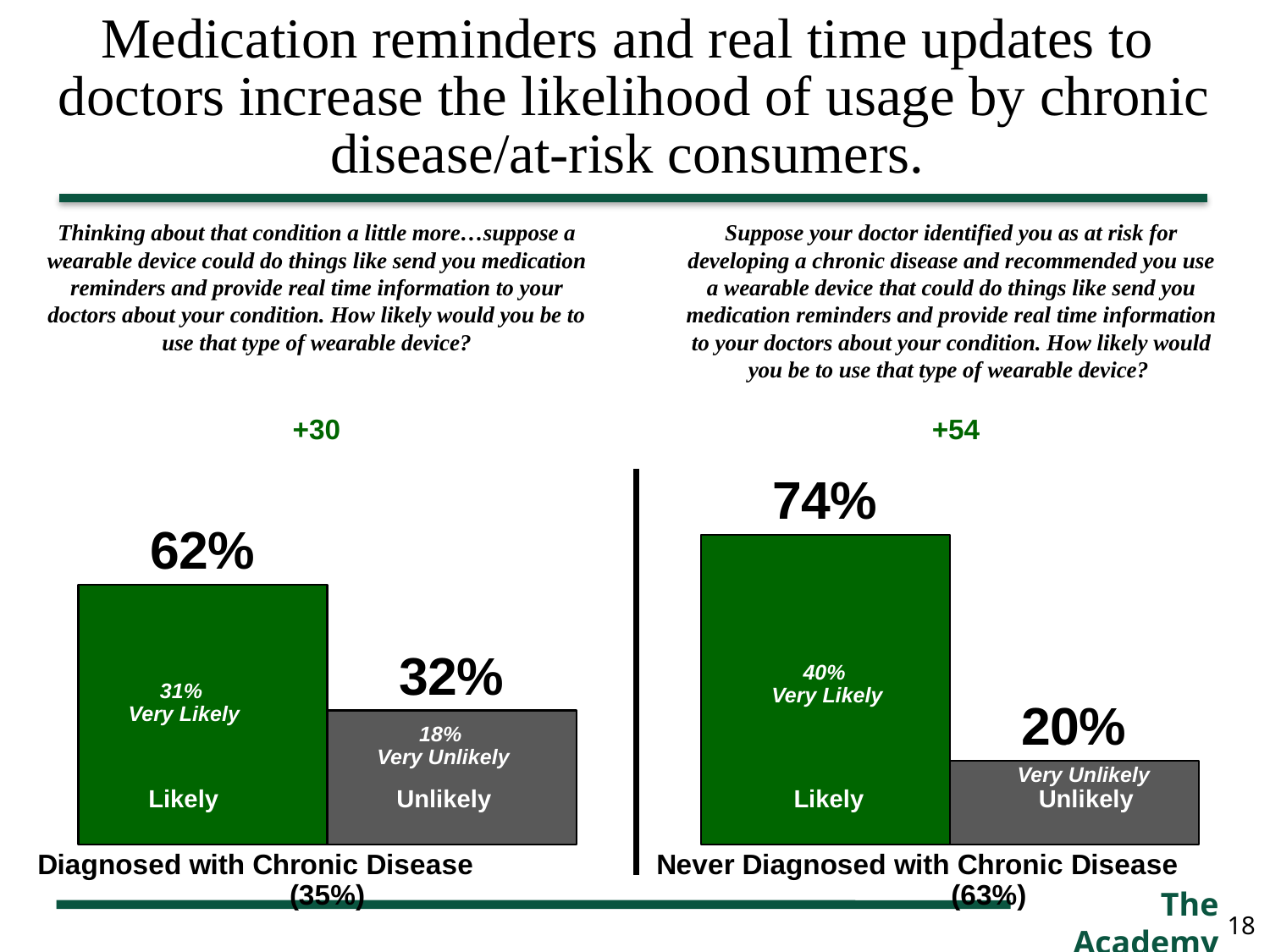
In the Diagnosed with Chronic Disease chart, what percentage are Unlikely to use the wearable device? 32% In the Diagnosed with Chronic Disease chart, what percentage are Likely to use the wearable device? 62% In the Never Diagnosed with Chronic Disease chart, what is the difference between the Likely and Unlikely percentages? 54 In the Diagnosed with Chronic Disease chart, what percentage are Very Likely to use the device? 31% In the Diagnosed with Chronic Disease chart, what is the difference between the Likely and Unlikely percentages? 30 In the Never Diagnosed with Chronic Disease chart, what percentage are Very Likely to use the device? 40% In the Diagnosed with Chronic Disease chart, what percentage are Very Unlikely to use the device? 18% In the Never Diagnosed with Chronic Disease chart, what percentage are Unlikely to use the wearable device? 20% What net score is shown above the Never Diagnosed with Chronic Disease chart? +54 What kind of chart is used on the left side of the slide for Diagnosed with Chronic Disease? Bar chart In the Never Diagnosed with Chronic Disease chart, what percentage are Likely to use the wearable device? 74% Which chart has the higher Likely percentage, Diagnosed with Chronic Disease or Never Diagnosed with Chronic Disease? Never Diagnosed with Chronic Disease